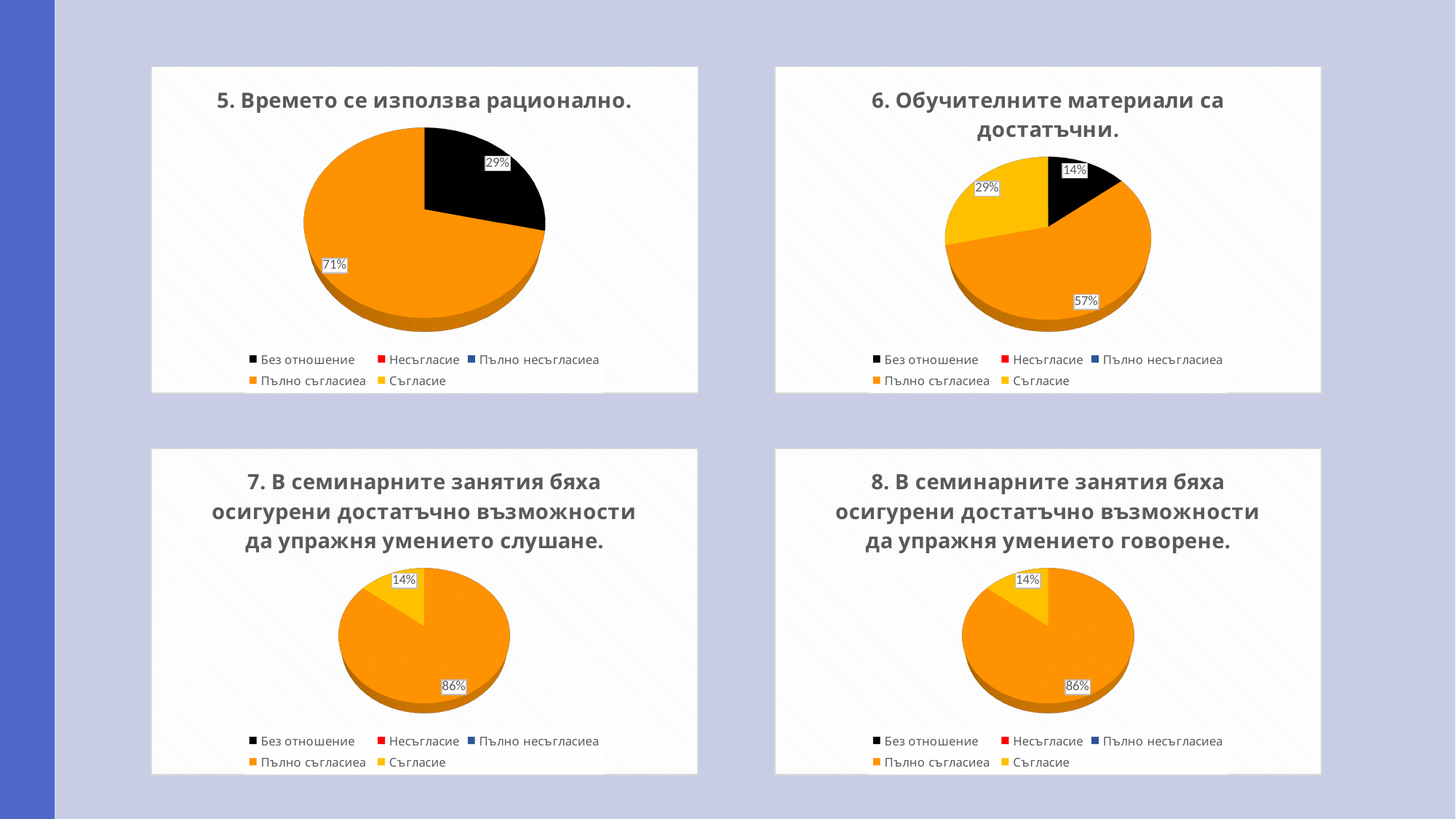
In the chart titled "5. Времето се използва рационално.", what is the difference between the "Пълно съгласиеа" and "Без отношение" shares? 42% In the chart titled "5. Времето се използва рационално.", what share is labelled for the "Без отношение" slice? 29% In the chart titled "5. Времето се използва рационално.", what share is labelled for the "Пълно съгласиеа" slice? 71% In the chart titled "6. Обучителните материали са достатъчни.", what share is labelled for the "Пълно съгласиеа" slice? 57% In the chart titled "6. Обучителните материали са достатъчни.", which is larger, the "Съгласие" slice or the "Без отношение" slice? Съгласие In the chart titled "8. В семинарните занятия бяха осигурени достатъчно възможности да упражня умението говорене.", what share is labelled for the "Съгласие" slice? 14% In the chart titled "6. Обучителните материали са достатъчни.", which slice is the smallest? Без отношение What type of chart is used in the top-left chart on the slide? Pie chart In the chart titled "6. Обучителните материали са достатъчни.", what share is labelled for the "Съгласие" slice? 29% In the chart titled "7. В семинарните занятия бяха осигурени достатъчно възможности да упражня умението слушане.", what share is labelled for the "Пълно съгласиеа" slice? 86% In the chart titled "6. Обучителните материали са достатъчни.", how many slices are shown in the pie? 3 How many entries does the legend list in the chart titled "7. В семинарните занятия бяха осигурени достатъчно възможности да упражня умението слушане."? 5